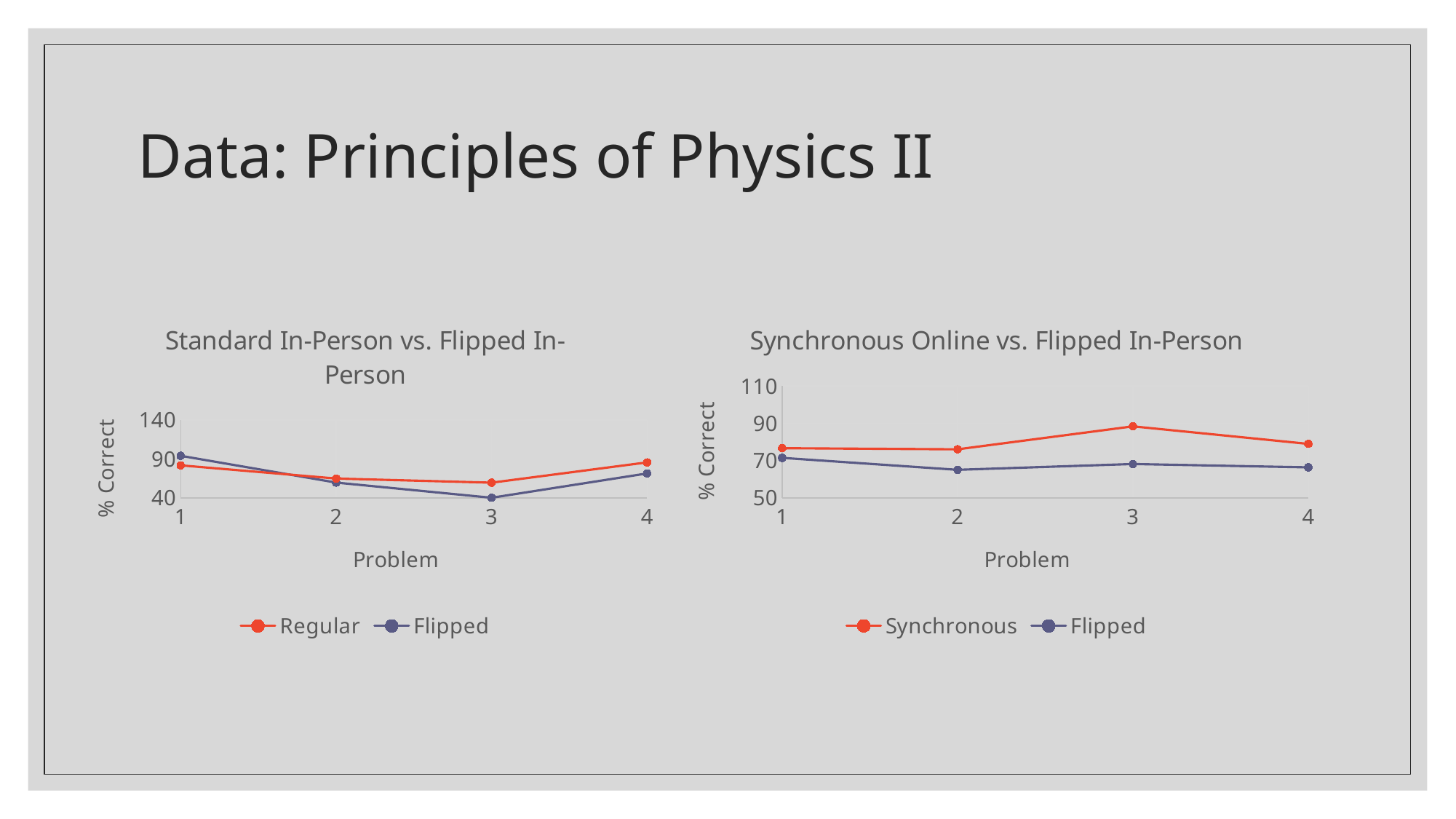
In the 'Synchronous Online vs. Flipped In-Person' chart, is the Flipped value for problem 2 greater or less than 70? less In the 'Standard In-Person vs. Flipped In-Person' chart, is the Flipped value for problem 3 greater or less than 90? less In the 'Standard In-Person vs. Flipped In-Person' chart, at which problem is the Flipped series lowest? 3 How many series does the legend of the 'Synchronous Online vs. Flipped In-Person' chart list? 2 In the 'Standard In-Person vs. Flipped In-Person' chart, does the Flipped series rise or fall from problem 1 to problem 3? fall In the 'Standard In-Person vs. Flipped In-Person' chart, which series has the larger value at problem 3, Regular or Flipped? Regular How many problems are plotted along the x axis of the 'Standard In-Person vs. Flipped In-Person' chart? 4 In the 'Synchronous Online vs. Flipped In-Person' chart, at which problem is the Synchronous series highest? 3 In the 'Standard In-Person vs. Flipped In-Person' chart, at which problem is the Flipped series highest? 1 What is the y-axis label of the 'Synchronous Online vs. Flipped In-Person' chart? % Correct In the 'Synchronous Online vs. Flipped In-Person' chart, is the Synchronous value for problem 3 greater or less than 70? greater What kind of chart is the 'Standard In-Person vs. Flipped In-Person' chart? line chart